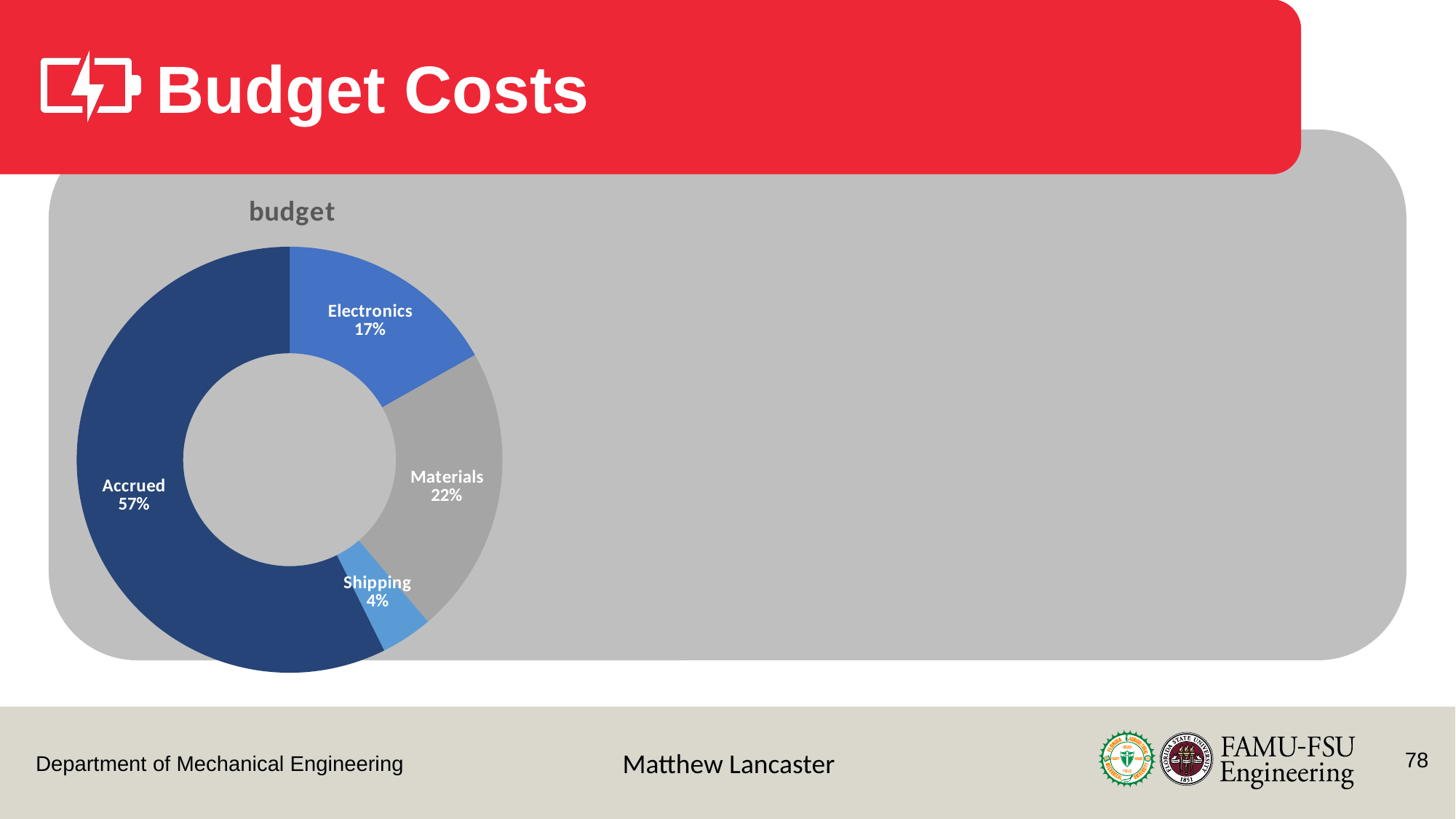
Which is larger, the Materials share or the Electronics share? Materials What share of the budget does Accrued account for? 57% What is the difference in percentage points between Electronics and Shipping? 13 What percentage of the budget is Shipping? 4% What percentage of the budget is Materials? 22% What is the title of the chart? budget What percentage of the budget is Electronics? 17% Which category has the smallest share of the budget? Shipping What kind of chart is shown on the slide? Doughnut chart Which category has the largest share of the budget? Accrued How many categories are shown in the chart? 4 How many percentage points larger is the Accrued share than the Materials share? 35